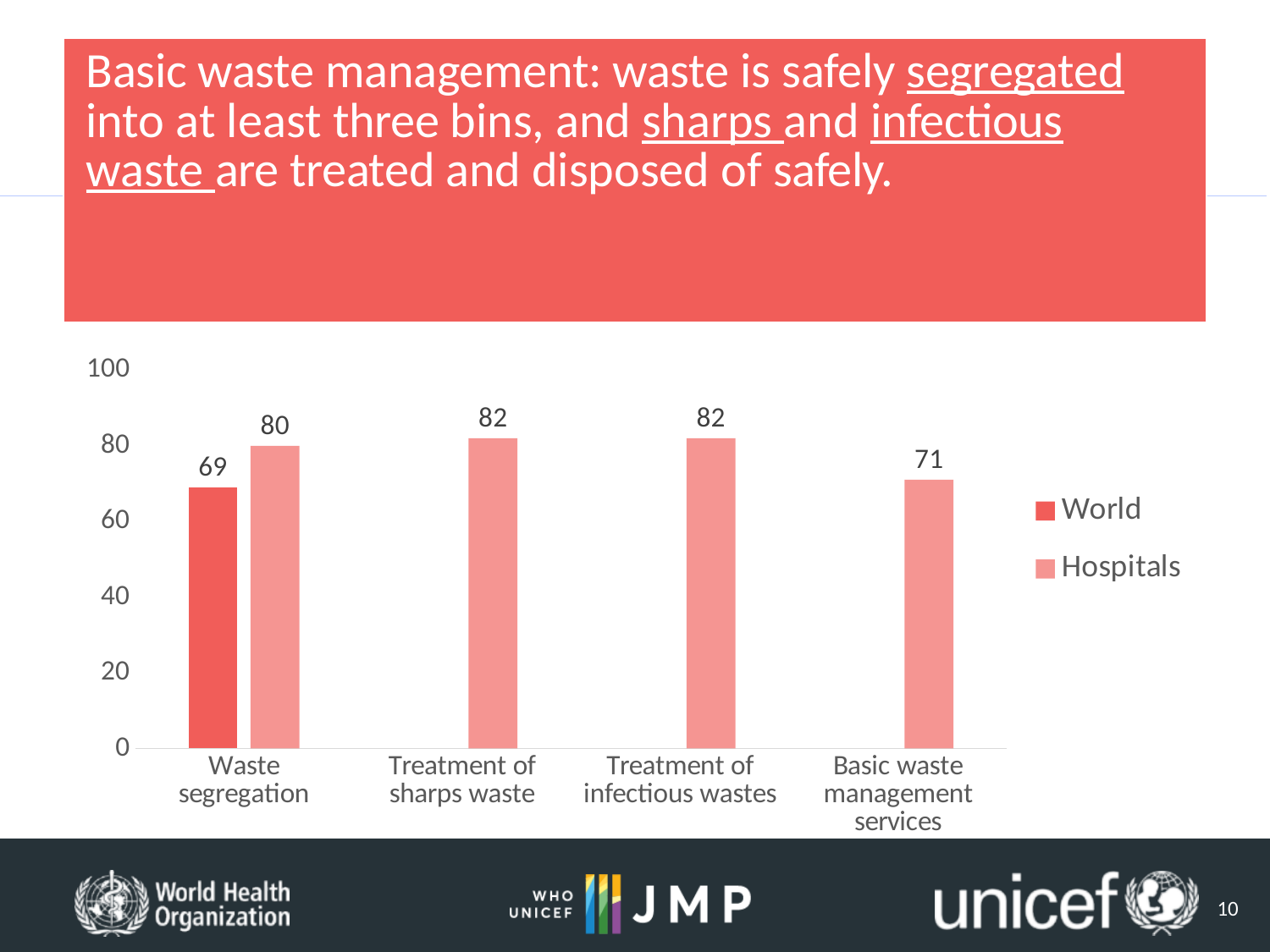
What is the Hospitals value for Treatment of sharps waste? 82 How many categories are shown on the x axis? 4 What kind of chart is shown on the slide? Bar chart How many series does the legend list? 2 What is the difference between the Hospitals values for Treatment of sharps waste and Basic waste management services? 11 What is the Hospitals value for Basic waste management services? 71 Which category has the lowest Hospitals value? Basic waste management services What is the difference between the Hospitals and World values for Waste segregation? 11 What is the Hospitals value for Waste segregation? 80 Is the Hospitals value for Treatment of infectious wastes greater or less than 80? greater Which is larger for Waste segregation, the World value or the Hospitals value? Hospitals What is the World value for Waste segregation? 69